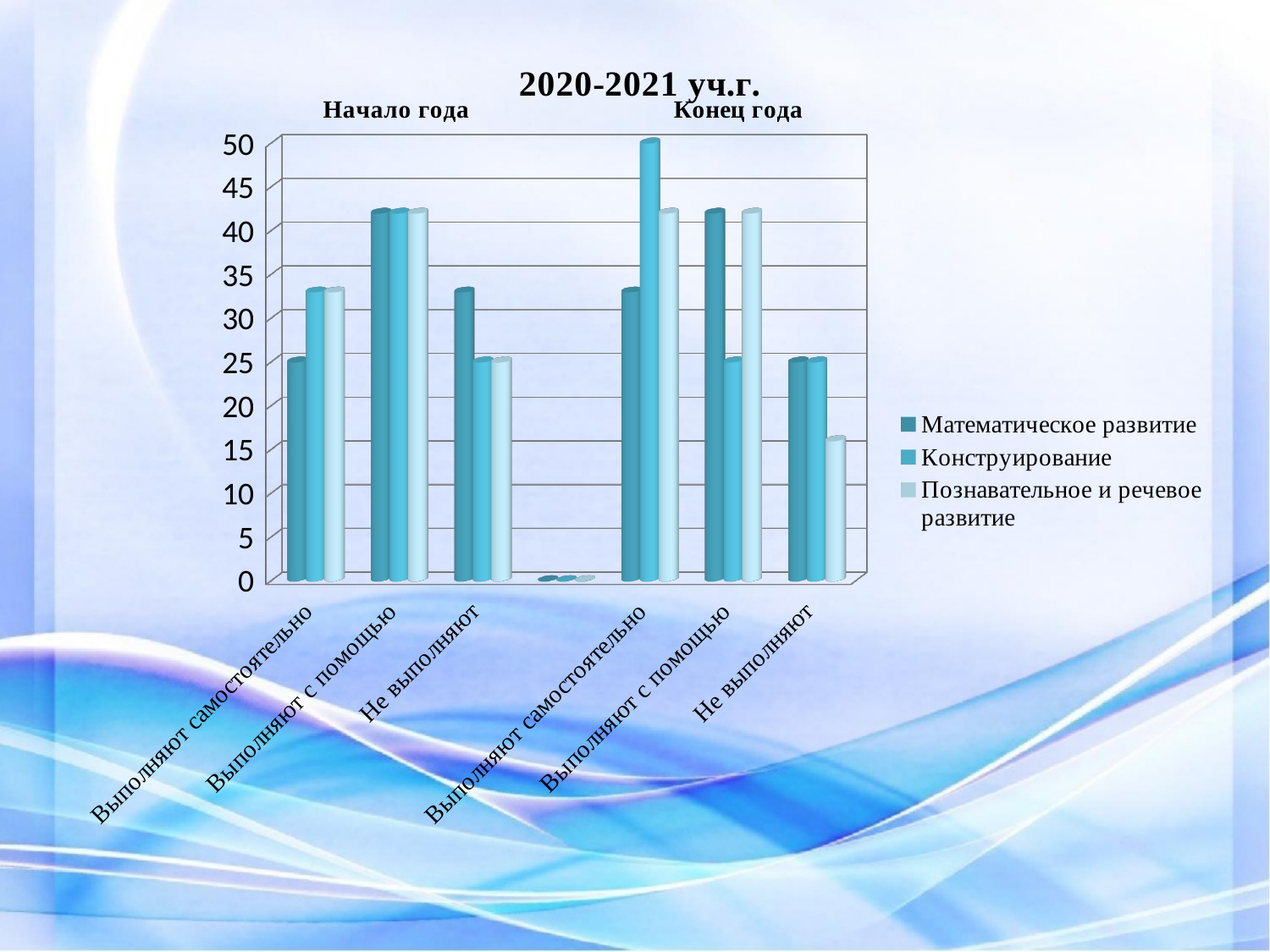
How many series does the legend list? 3 Under "Начало года", for "Выполняют самостоятельно", which is larger: Математическое развитие or Конструирование? Конструирование Is the value for Математическое развитие under "Начало года" for "Выполняют самостоятельно" greater or less than 30? less Is the value for Математическое развитие under "Начало года" for "Выполняют с помощью" greater or less than 40? greater Under "Конец года", which series has the lowest value for "Не выполняют"? Познавательное и речевое развитие Is the value for Познавательное и речевое развитие under "Конец года" for "Не выполняют" greater or less than 20? less Under "Конец года", for "Выполняют с помощью", which is larger: Математическое развитие or Конструирование? Математическое развитие Under "Конец года", which series has the highest value for "Выполняют самостоятельно"? Конструирование What kind of chart is shown on the slide? bar chart What is the title of the chart? 2020-2021 уч.г. How many categories are shown under "Начало года"? 3